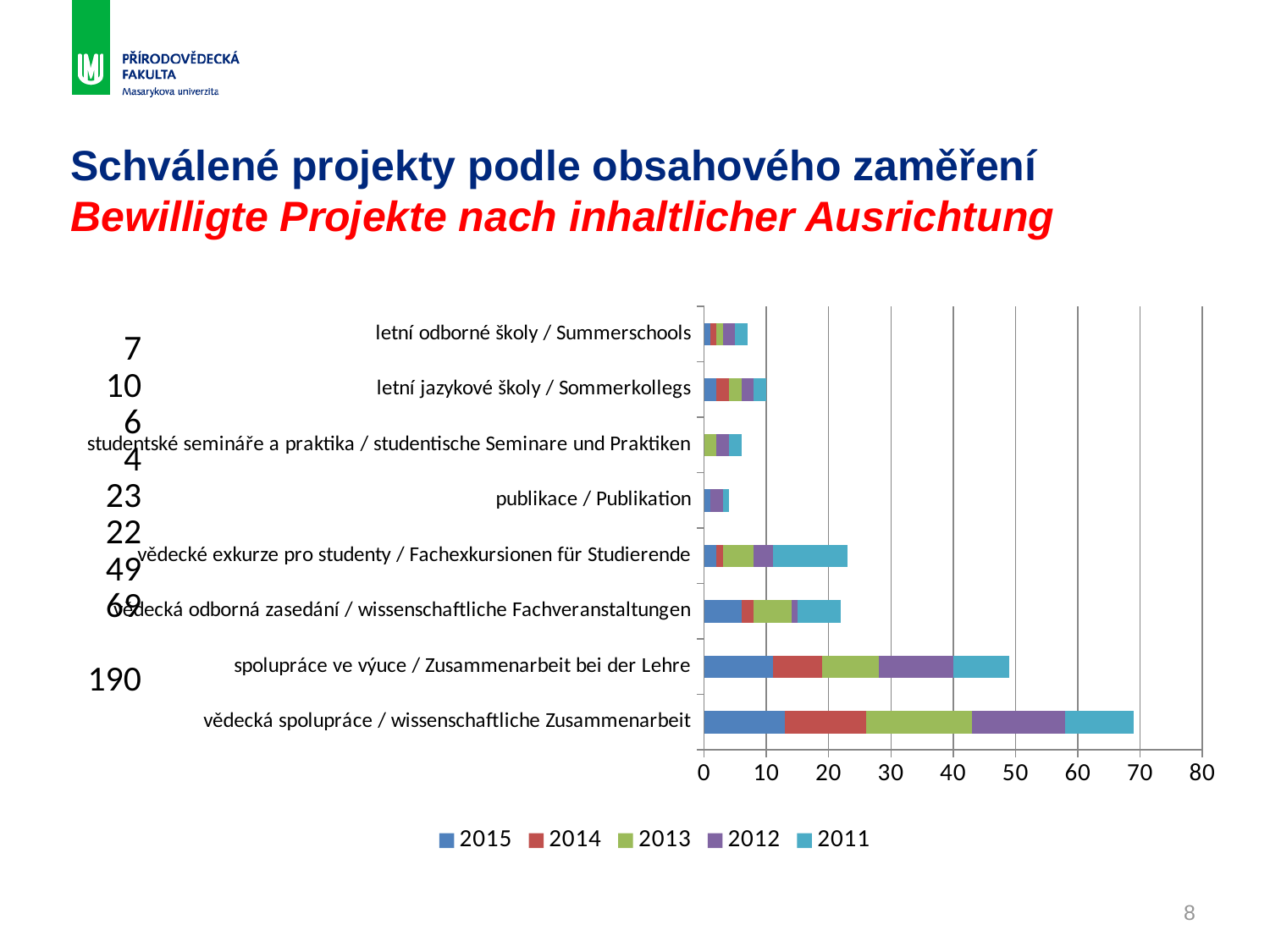
Is the total bar for spolupráce ve výuce / Zusammenarbeit bei der Lehre greater or less than 40? greater Which category has the longest total bar? vědecká spolupráce / wissenschaftliche Zusammenarbeit Which has the longer total bar: spolupráce ve výuce / Zusammenarbeit bei der Lehre or vědecká odborná zasedání / wissenschaftliche Fachveranstaltungen? spolupráce ve výuce / Zusammenarbeit bei der Lehre What is the Czech title of the slide above the chart? Schválené projekty podle obsahového zaměření Which has the longer total bar: vědecké exkurze pro studenty / Fachexkursionen für Studierende or letní jazykové školy / Sommerkollegs? vědecké exkurze pro studenty / Fachexkursionen für Studierende Which category has the shortest total bar? publikace / Publikation Is the total bar for letní jazykové školy / Sommerkollegs greater or less than 20? less Which year is listed first in the legend? 2015 How many categories are plotted on the chart? 8 What kind of chart is shown on the slide? Stacked bar chart How many series does the legend list? 5 Is the total bar for vědecká spolupráce / wissenschaftliche Zusammenarbeit greater or less than 60? greater